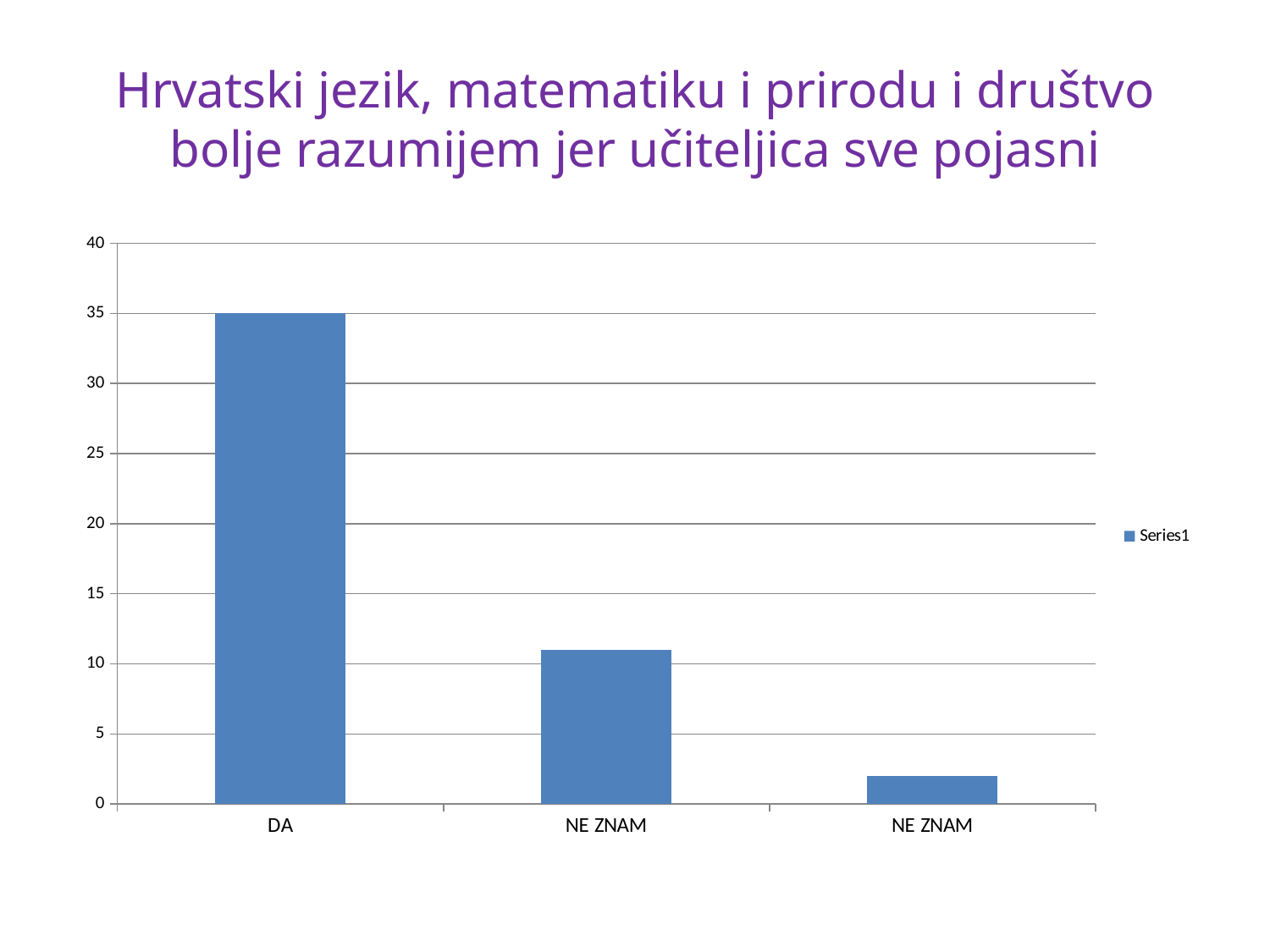
Is the value for DA greater or less than 30? greater What is the label of the leftmost category on the x axis? DA What is the name of the series shown in the legend? Series1 Is the value of the rightmost bar (the second NE ZNAM) greater or less than 5? less What is the value of the bar for DA? 35 Which category has the highest bar? DA What kind of chart is shown on the slide? bar chart Is the value of the middle bar (the first NE ZNAM) greater or less than 10? greater How many bars are plotted in the chart? 3 Which is larger, the bar for DA or the middle NE ZNAM bar? DA Do the bar values rise or fall from left to right across the x axis? fall How many series does the legend list? 1